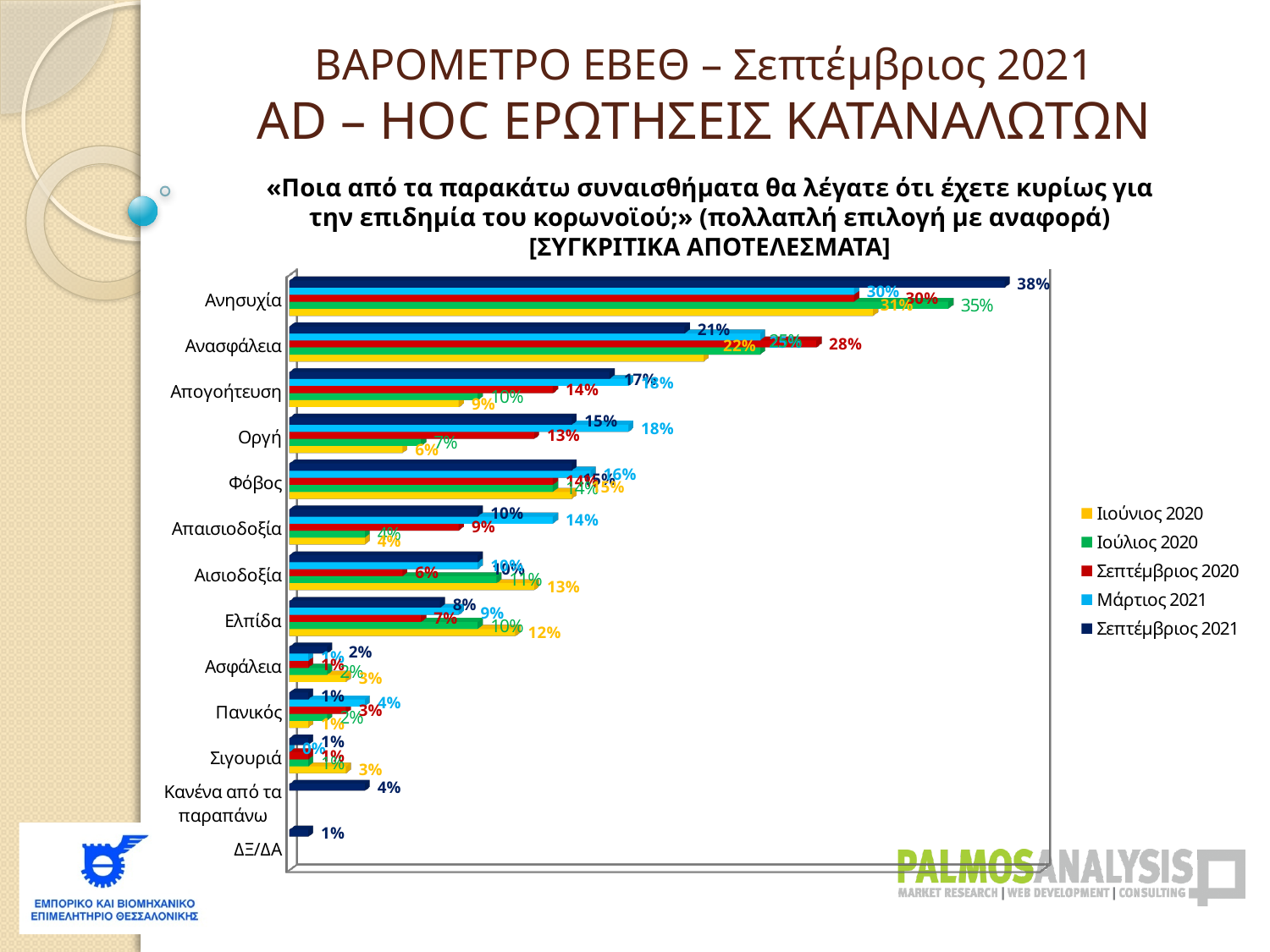
What is the value for ΔΞ/ΔΑ in the Σεπτέμβριος 2021 series? 1% How many series does the legend list? 5 For Οργή, which is larger: the Μάρτιος 2021 value or the Σεπτέμβριος 2021 value? Μάρτιος 2021 What is the value for Οργή in the Μάρτιος 2021 series? 18% What is the value for Ανησυχία in the Σεπτέμβριος 2021 series? 38% What is the value for Κανένα από τα παραπάνω in the Σεπτέμβριος 2021 series? 4% Which category has the highest value in the Σεπτέμβριος 2021 series? Ανησυχία How many categories are shown on the chart? 13 What kind of chart is shown on the slide? Bar chart What is the difference between the Σεπτέμβριος 2021 values for Ανησυχία and Ανασφάλεια? 17 percentage points What is the value for Ανασφάλεια in the Σεπτέμβριος 2020 series? 28% What is the value for Ελπίδα in the Ιούνιος 2020 series? 12%